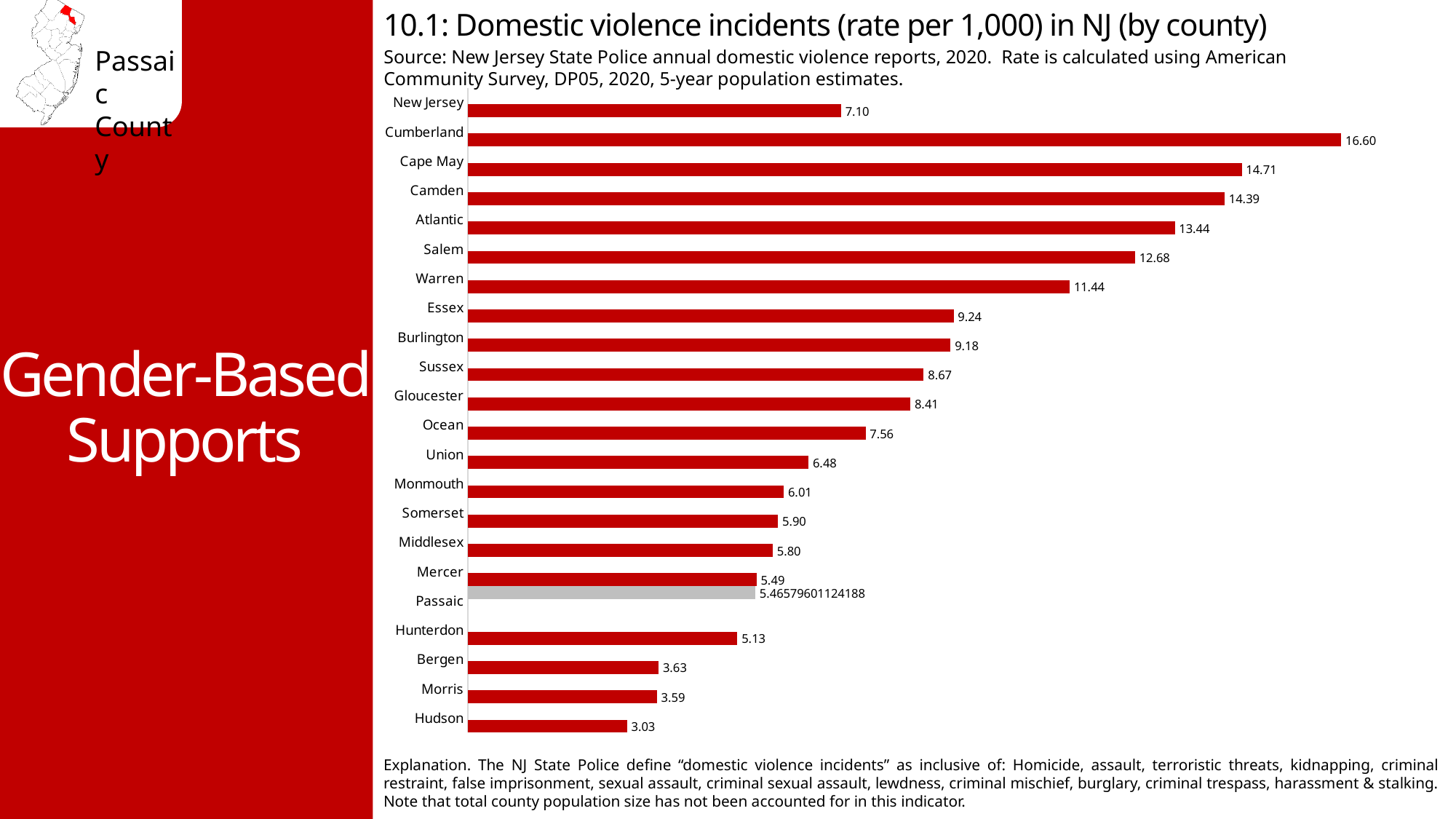
What is the rate shown for Passaic county? 5.46579601124188 Which has a higher rate, Warren or Essex? Warren What type of chart is shown on the slide? Bar chart What is the domestic violence incident rate per 1,000 for Hudson county? 3.03 What is the difference between the rates for Cape May and Camden? 0.32 What is the domestic violence incident rate per 1,000 for Cumberland county? 16.60 What is the difference between the rates for Cumberland and Hudson? 13.57 Which has a higher rate, Ocean or Union? Ocean What is the rate shown for New Jersey as a whole? 7.10 Which county has the lowest domestic violence incident rate? Hudson Which county has the highest domestic violence incident rate? Cumberland How many bars (categories) are plotted in the chart? 22